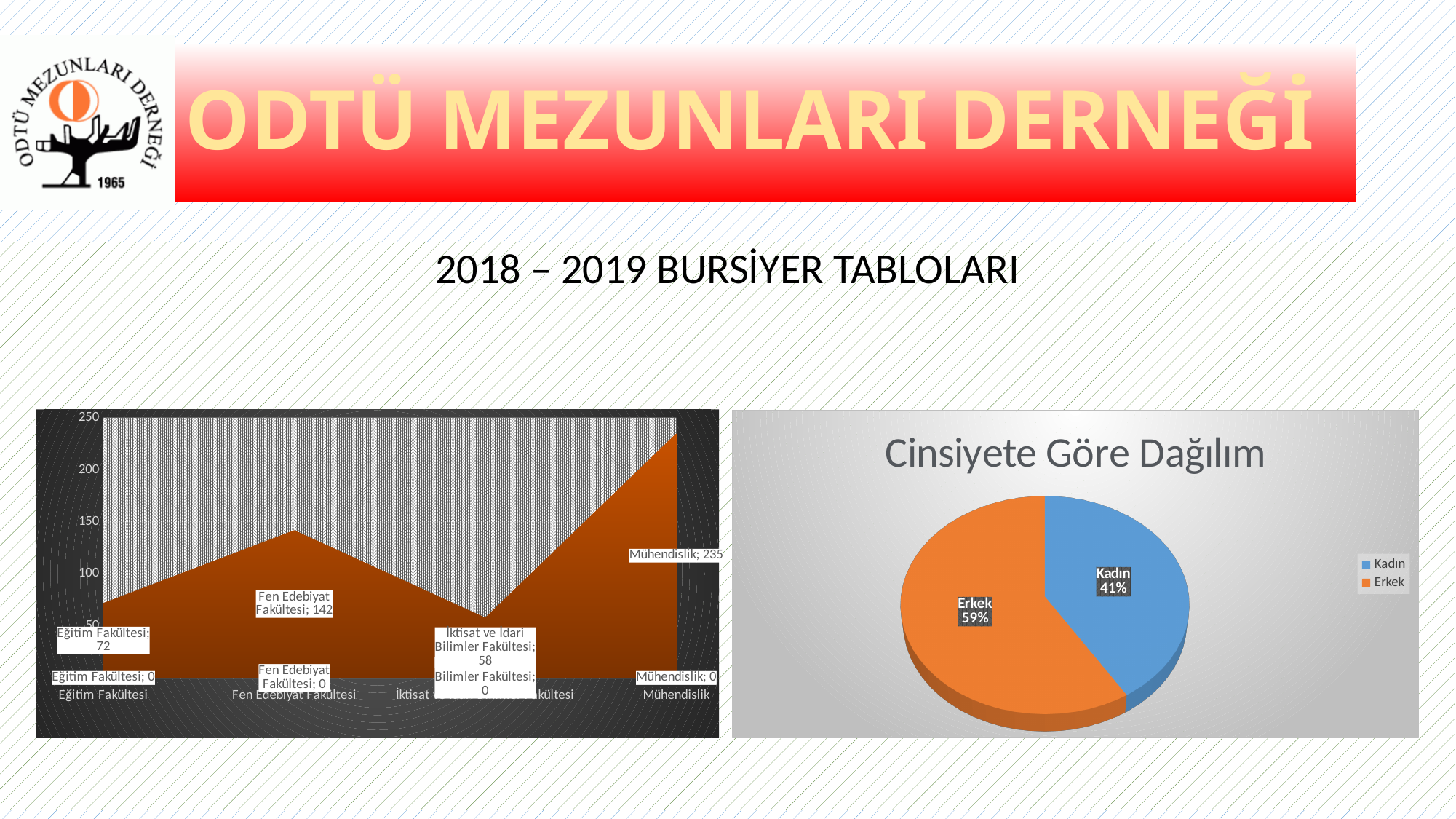
In the left chart, which category has the highest value? Mühendislik How many entries does the legend of the pie chart 'Cinsiyete Göre Dağılım' list? 2 In the left chart, what is the value for Eğitim Fakültesi? 72 In the left chart, what is the value for Fen Edebiyat Fakültesi? 142 In the pie chart titled 'Cinsiyete Göre Dağılım', what share is Erkek? 59% How many faculty categories are shown on the x axis of the left chart? 4 In the left chart, which category has the lowest non-zero value? İktisat ve İdari Bilimler Fakültesi In the left chart, which is larger: the value for Eğitim Fakültesi or the value for İktisat ve İdari Bilimler Fakültesi? Eğitim Fakültesi In the left chart, what is the value for İktisat ve İdari Bilimler Fakültesi? 58 In the left chart, what is the value for Mühendislik? 235 In the pie chart titled 'Cinsiyete Göre Dağılım', what share is Kadın? 41% In the left chart, what is the difference between the values for Mühendislik and Fen Edebiyat Fakültesi? 93